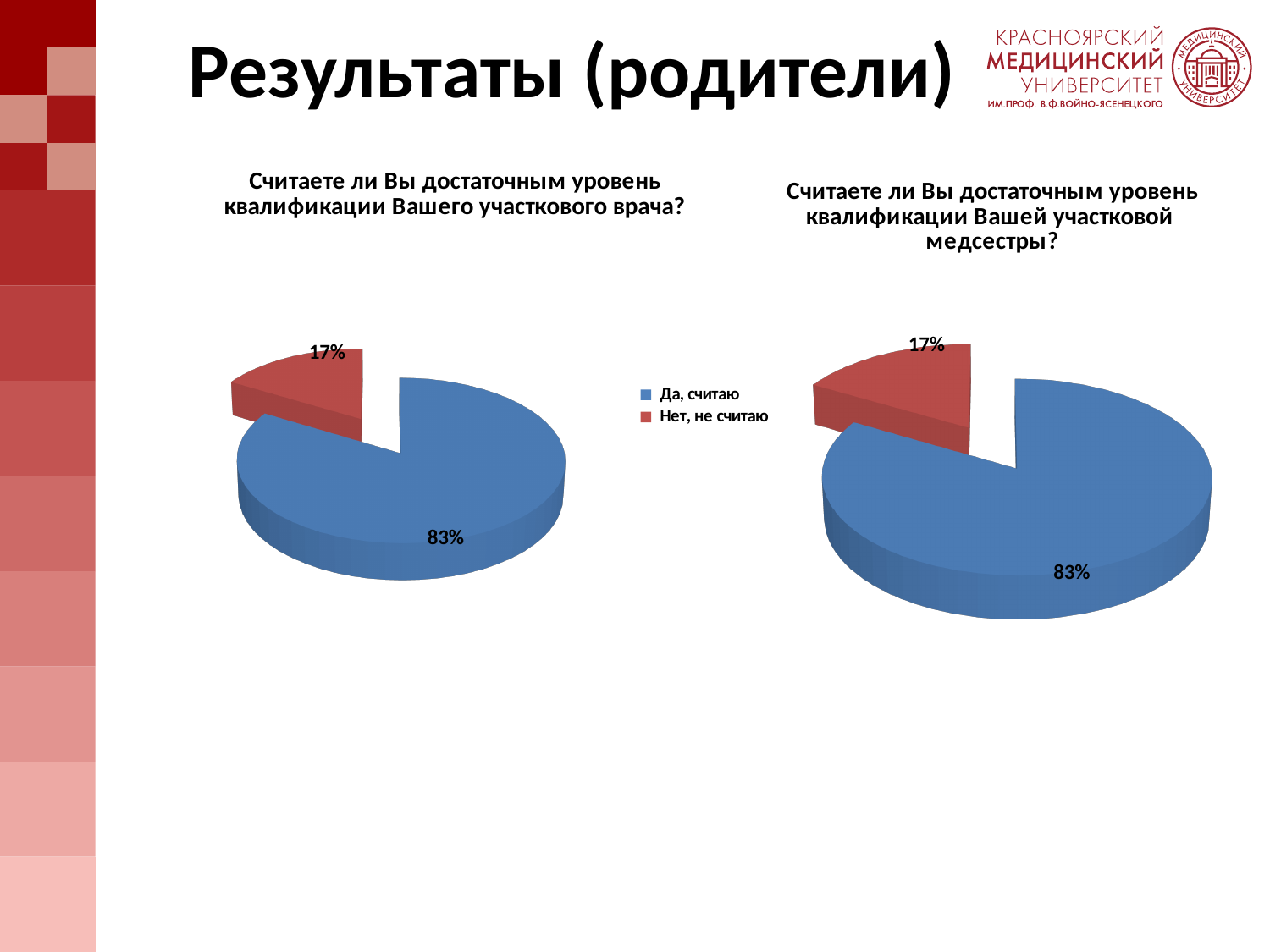
In the right chart (about the district nurse), what share of respondents answered "Да, считаю"? 83% How many entries does the legend list? 2 How many slices does the right chart (about the district nurse) have? 2 In the right chart (about the district nurse), which is larger: the "Да, считаю" slice or the "Нет, не считаю" slice? Да, считаю In the left chart (about the district doctor), which answer has the largest slice? Да, считаю In the left chart (about the district doctor), what share of respondents answered "Да, считаю"? 83% What colour represents "Нет, не считаю" in the charts? Red In the left chart (about the district doctor), what share of respondents answered "Нет, не считаю"? 17% In the right chart (about the district nurse), which answer has the smallest slice? Нет, не считаю In the left chart (about the district doctor), what is the difference in percentage points between the "Да, считаю" and "Нет, не считаю" slices? 66 percentage points In the right chart (about the district nurse), what share of respondents answered "Нет, не считаю"? 17% What type of chart is used on the left of the slide? Pie chart